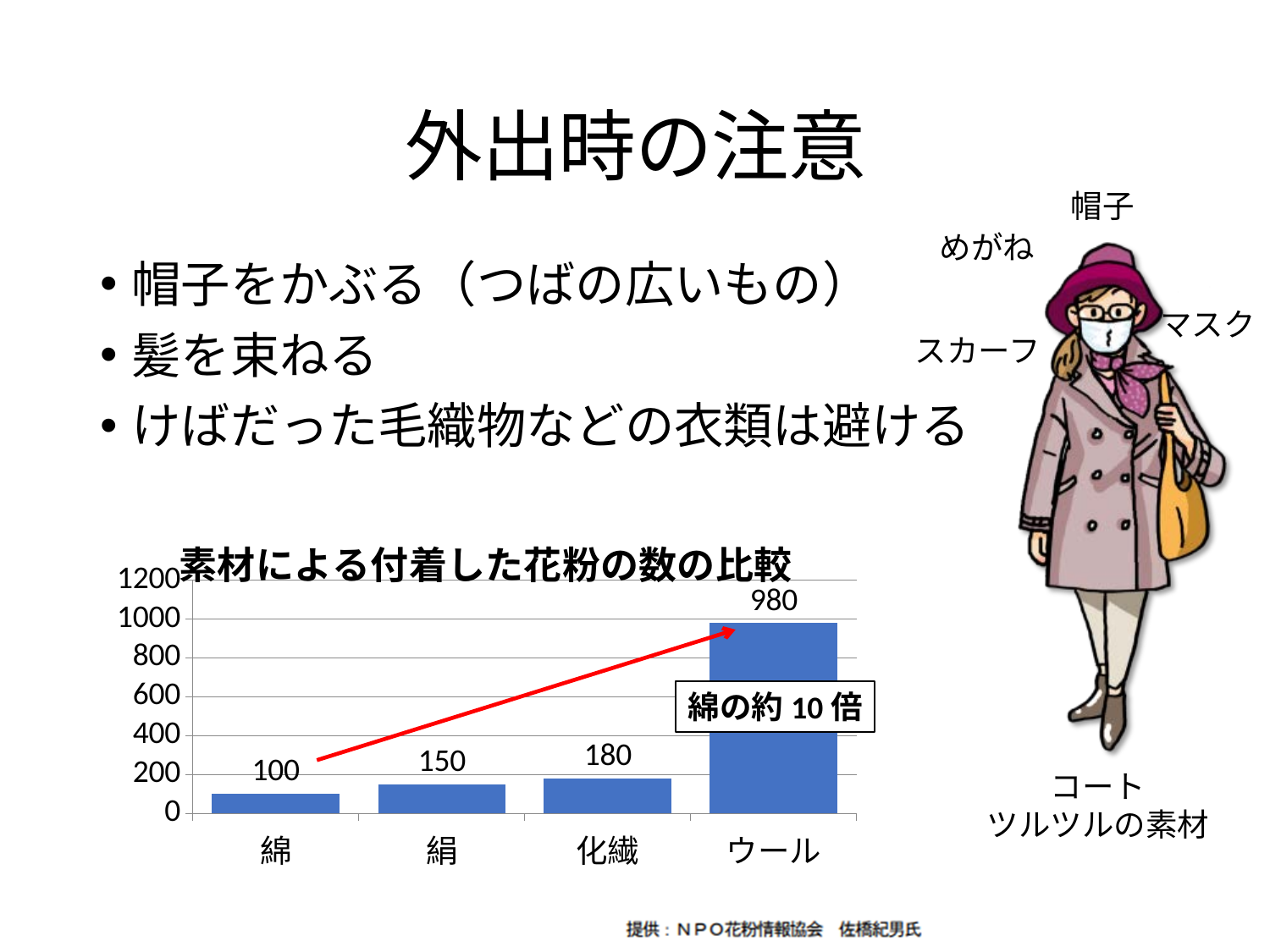
What is the difference between the values for ウール and 綿? 880 Which category has the highest value in the chart? ウール Which category has the lowest value in the chart? 綿 How many categories are shown in the chart? 4 What is the value for 化繊 in the chart? 180 What is the difference between the values for 化繊 and 絹? 30 Which is larger, the value for 絹 or the value for 化繊? 化繊 What is the title of the chart? 素材による付着した花粉の数の比較 What is the value for 綿 in the chart? 100 What is the value for ウール in the chart? 980 What kind of chart is shown on the slide? Bar chart What is the value for 絹 in the chart? 150